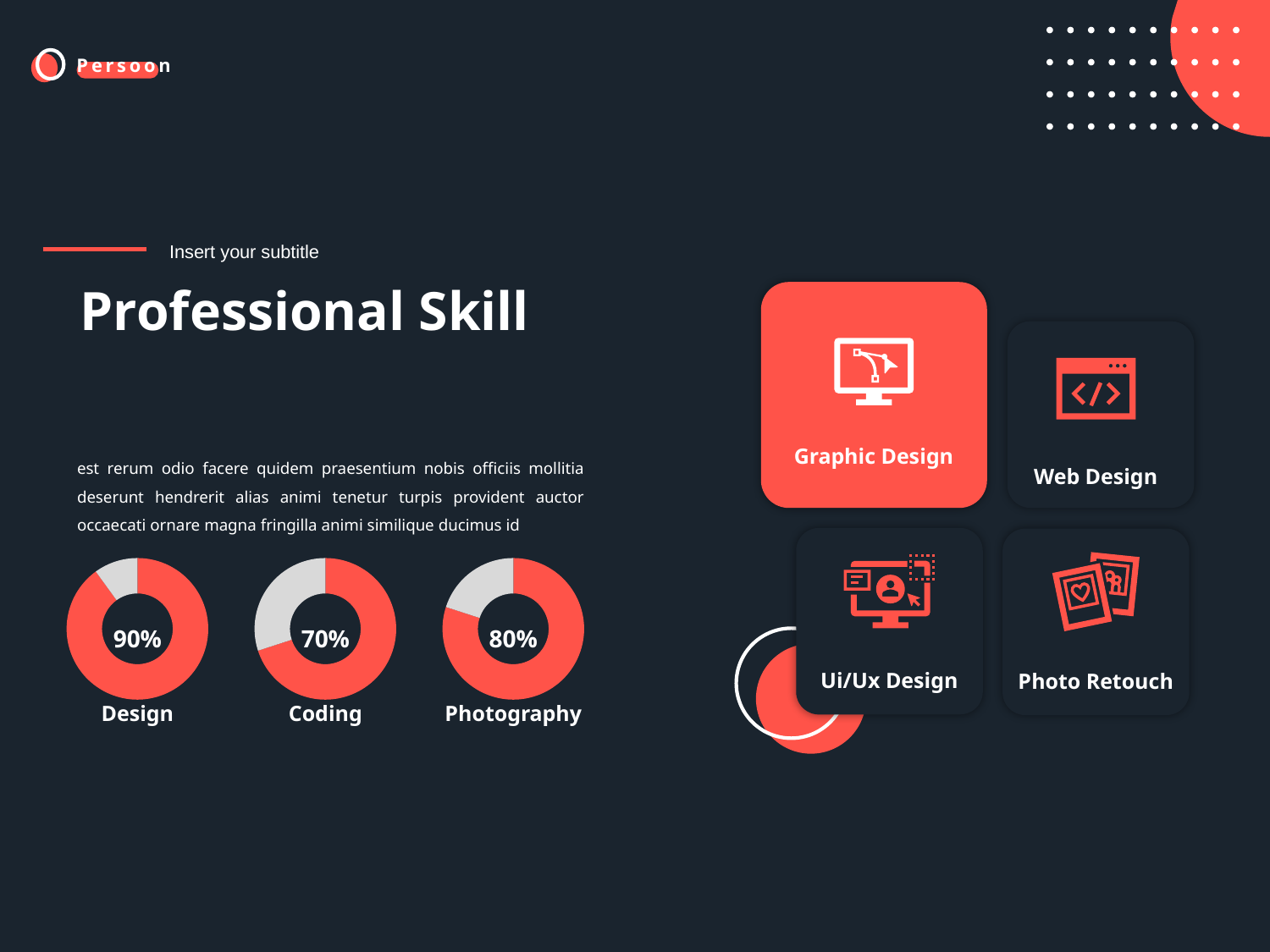
What is the difference between the Photography and Coding percentages? 10% Which is larger, the Photography percentage or the Coding percentage? Photography What percentage is shown in the Coding donut chart? 70% What kind of chart is used to show the skill percentages? Donut chart What colour is the filled portion of each skill donut chart? Red Which of the three skill donut charts shows the highest percentage? Design What is the title of the slide containing the skill charts? Professional Skill What is the difference between the Design and Coding percentages? 20% Which of the three skill donut charts shows the lowest percentage? Coding What percentage is shown in the Photography donut chart? 80% What percentage is shown in the Design donut chart? 90% How many donut charts are shown on the slide? 3